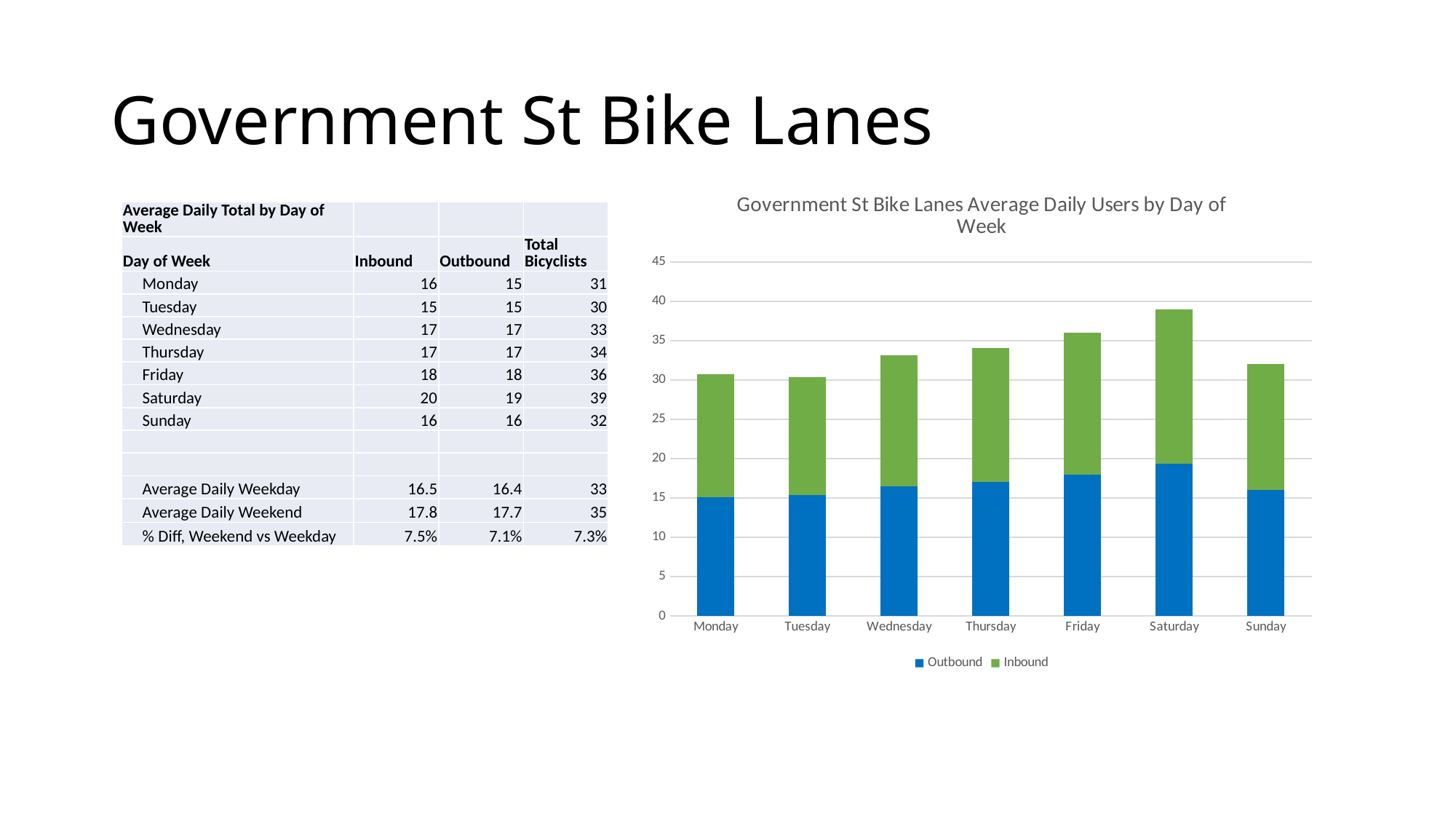
Is the total bar for Saturday greater or less than 35? greater What kind of chart is shown on the slide? Stacked bar chart Is the Outbound segment for Friday greater or less than 15? greater Which day has the largest Outbound segment on the chart? Saturday Is the total bar for Sunday greater or less than 35? less Which day has the highest total bar on the chart? Saturday Which has the taller total bar, Saturday or Sunday? Saturday Which has the taller total bar, Friday or Tuesday? Friday How many series does the chart legend list? 2 Which colour represents the Inbound series in the chart? Green How many days of the week are plotted on the chart? 7